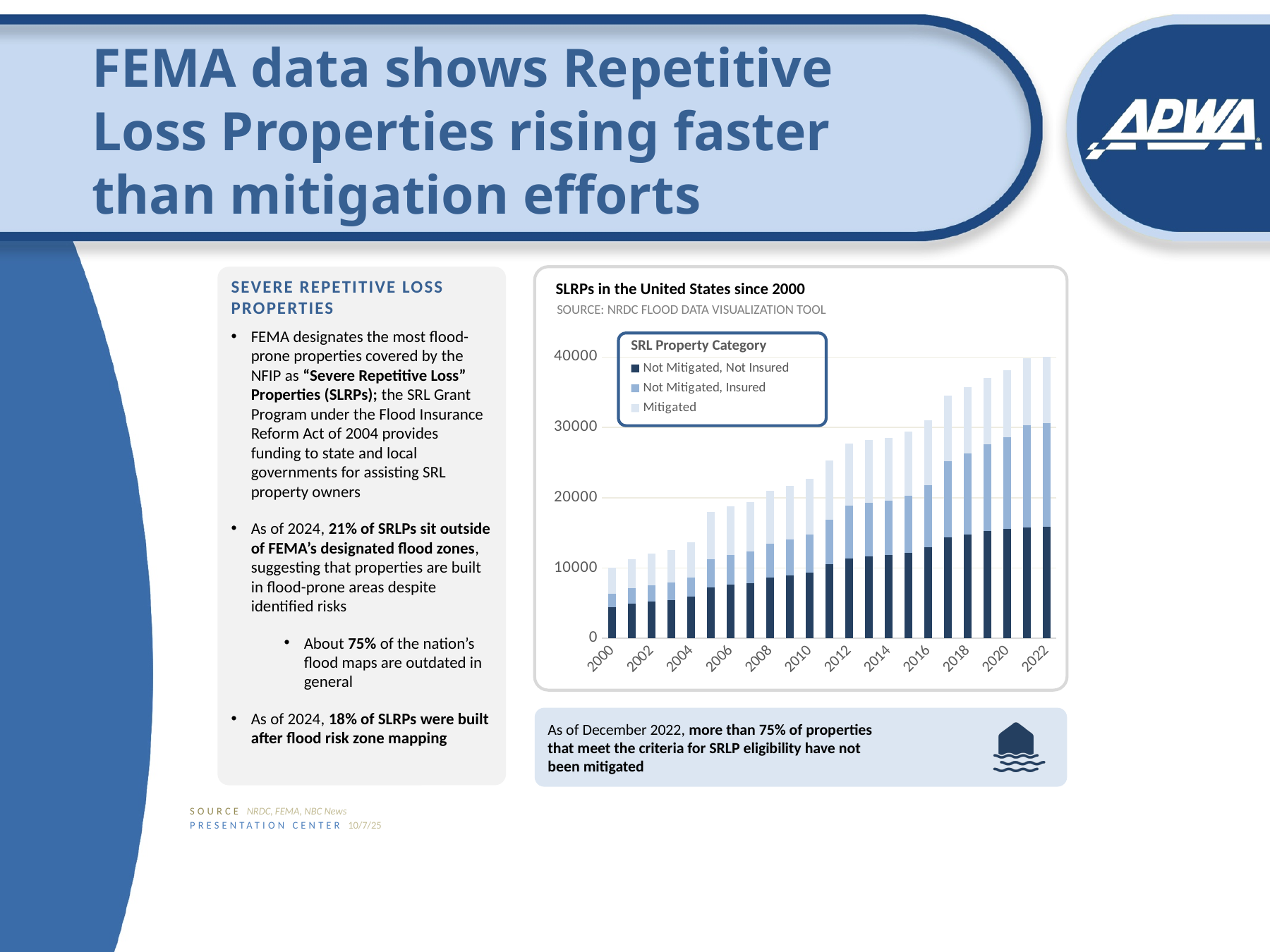
What is the title of the legend in the chart? SRL Property Category Is the total number of SLRPs in 2022 greater or less than 30000? greater Is the total number of SLRPs in 2010 greater or less than 20000? greater Which year has the lowest total number of SLRPs in the chart? 2000 Do the total SLRP values rise or fall from 2000 to 2022? Rise How many years (bars) are plotted in the 'SLRPs in the United States since 2000' chart? 23 Which year has the highest total number of SLRPs in the chart? 2022 In 2022, which SRL property category has the smallest segment of the bar? Mitigated Which year has a larger total of SLRPs, 2000 or 2022? 2022 Is the total number of SLRPs in 2004 greater or less than 10000? greater What kind of chart is shown on the slide? Stacked bar chart How many series does the legend of the 'SLRPs in the United States since 2000' chart list? 3